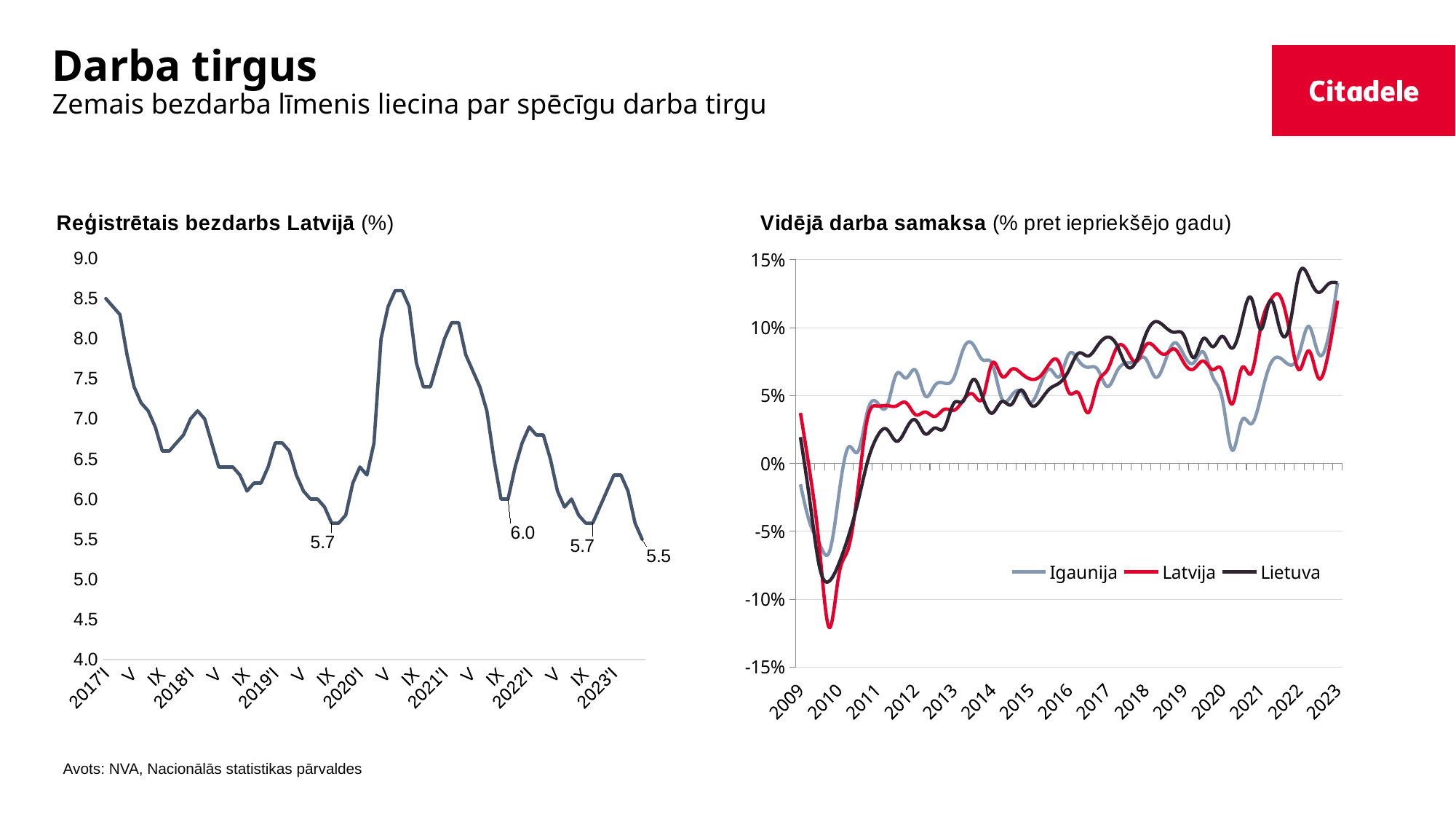
In the 'Reģistrētais bezdarbs Latvijā' chart, what is the last labelled value at the end of the line (2023)? 5.5 Which countries are listed in the legend of the 'Vidējā darba samaksa' chart? Igaunija, Latvija, Lietuva In the 'Reģistrētais bezdarbs Latvijā' chart, which is larger: the labelled value near 2022'I or the final labelled value in 2023? the value near 2022'I (6.0) In the 'Vidējā darba samaksa' chart, is the lowest value of the Latvija line around 2010 greater or less than -10%? less In the 'Vidējā darba samaksa' chart, what colour is the Latvija line? red In the 'Reģistrētais bezdarbs Latvijā' chart, is the value at 2017'I greater or less than 8.0? greater How many series does the legend of the 'Vidējā darba samaksa' chart list? 3 In the 'Reģistrētais bezdarbs Latvijā' chart, what value is labelled at the dip around 2022'I? 6.0 In the 'Reģistrētais bezdarbs Latvijā' chart, does the unemployment rate overall rise or fall from 2017'I to 2023'I? fall What kind of chart is 'Reģistrētais bezdarbs Latvijā (%)'? line chart In the 'Reģistrētais bezdarbs Latvijā' chart, what is the difference between the labelled value 6.0 and the final labelled value 5.5? 0.5 In the 'Vidējā darba samaksa' chart, which series reaches the lowest point around 2010? Latvija